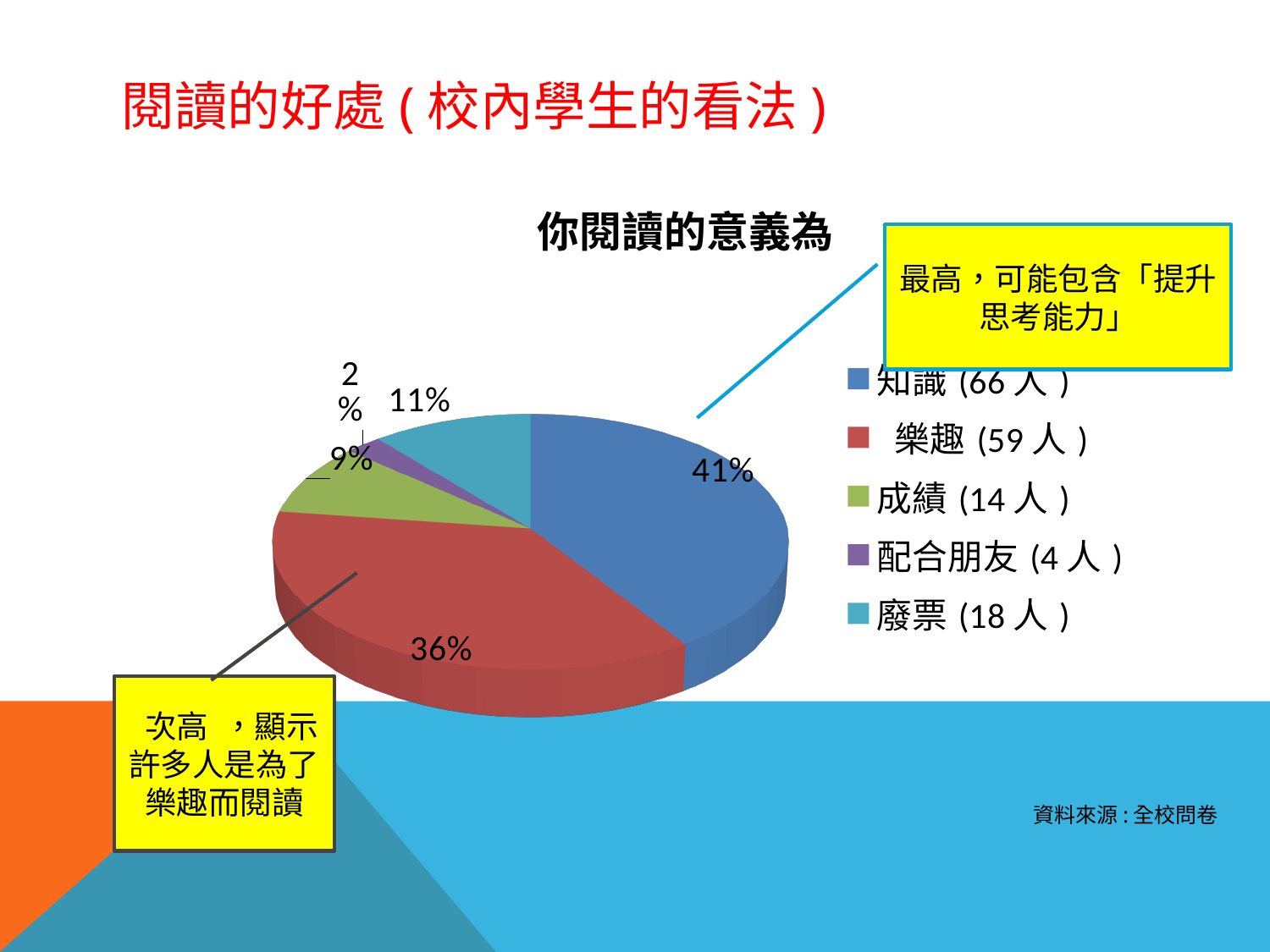
Which category has the largest share of the pie? 知識 What is the difference in percentage points between the 知識 and 樂趣 slices? 5% What percentage of the pie does 知識 account for? 41% What percentage of the pie does 樂趣 account for? 36% How many categories does the pie chart have? 5 How many people chose 樂趣 according to the legend? 59 人 Which has a larger share of the pie, 廢票 or 成績? 廢票 Which category has the smallest share of the pie? 配合朋友 What type of chart is shown on the slide? Pie chart What percentage of the pie does 成績 account for? 9% What is the title of the pie chart? 你閱讀的意義為